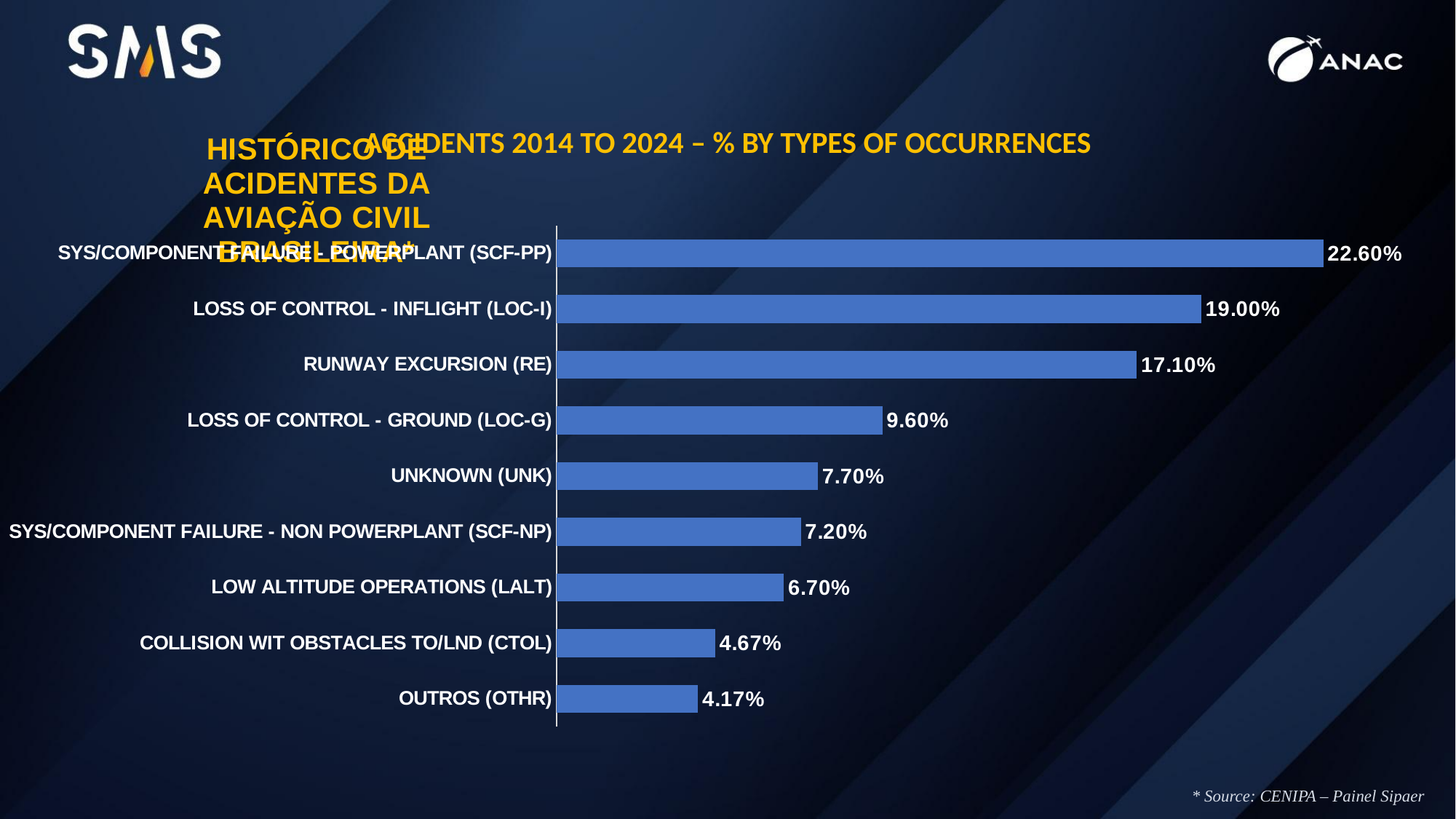
What kind of chart is shown on the slide? Bar chart Which type of occurrence has the lowest percentage? OUTROS (OTHR) What is the value for RUNWAY EXCURSION (RE)? 17.10% What is the difference between the values for SYS/COMPONENT FAILURE - POWERPLANT (SCF-PP) and OUTROS (OTHR)? 18.43% What is the title of the chart? ACCIDENTS 2014 TO 2024 – % BY TYPES OF OCCURRENCES How many types of occurrences are shown in the chart? 9 What is the value for UNKNOWN (UNK)? 7.70% What is the difference between the values for LOSS OF CONTROL - INFLIGHT (LOC-I) and RUNWAY EXCURSION (RE)? 1.90% Which type of occurrence has the highest percentage? SYS/COMPONENT FAILURE - POWERPLANT (SCF-PP) Which is larger, the value for UNKNOWN (UNK) or the value for LOW ALTITUDE OPERATIONS (LALT)? UNKNOWN (UNK) What is the value for LOSS OF CONTROL - GROUND (LOC-G)? 9.60% What is the value for COLLISION WIT OBSTACLES TO/LND (CTOL)? 4.67%